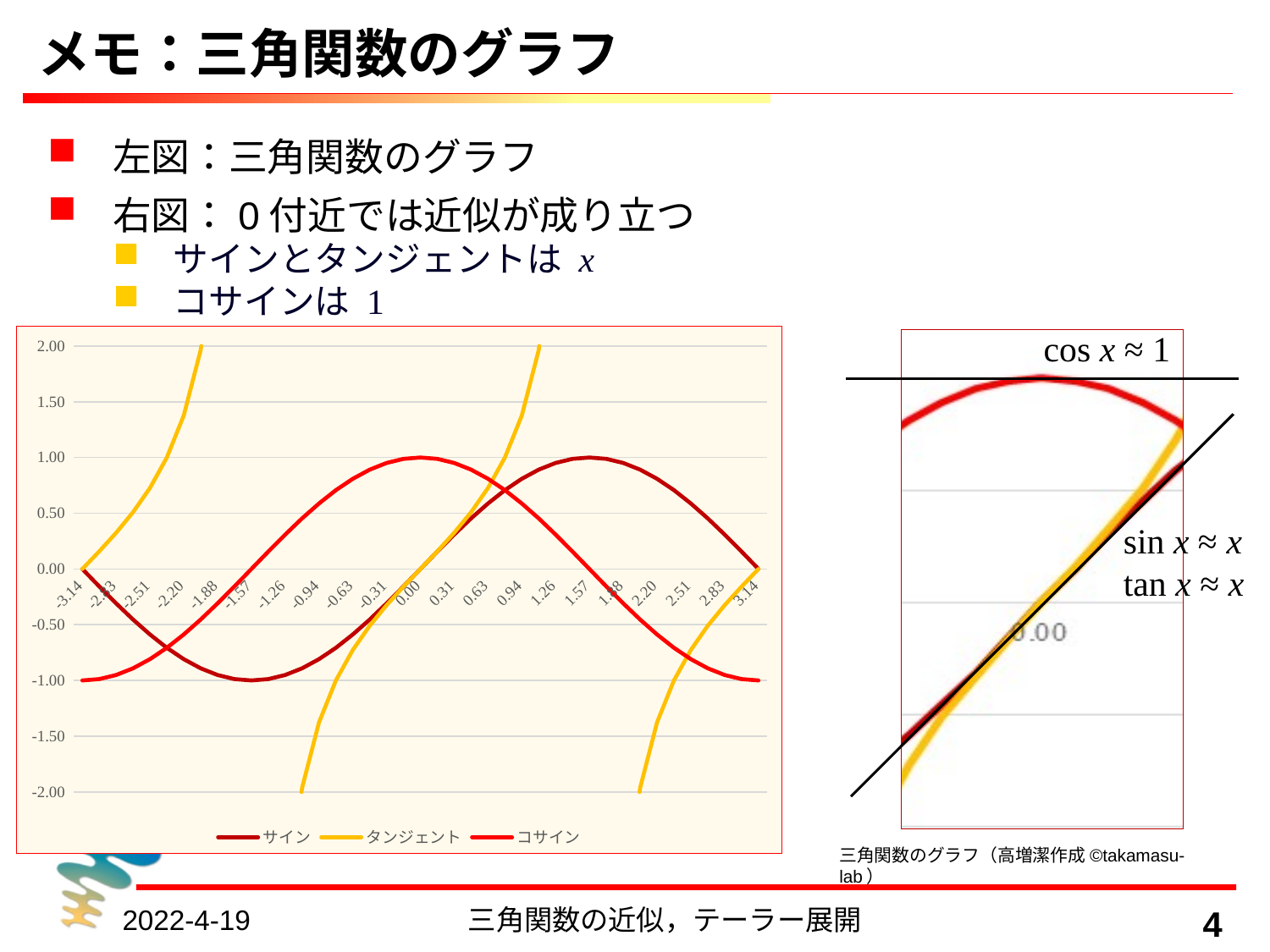
On the left chart, does the コサイン line rise or fall as x goes from 0.00 to 3.14? fall What kind of chart is shown on the left of the slide? line chart What is the highest value shown on the y axis of the left chart? 2.00 On the left chart, is the value of タンジェント at x = 0.94 greater or less than 1.00? greater How many series does the legend of the left chart list? 3 On the left chart, at x = 0.00, which is larger, サイン or コサイン? コサイン What are the three series named in the legend of the left chart? サイン, タンジェント, コサイン On the left chart, is the value of タンジェント at x = -0.94 greater or less than -1.00? less On the left chart, what is the value of サイン at x = 0.00? 0.00 On the left chart, what is the value of コサイン at x = 0.00? 1.00 On the left chart, what is the value of コサイン at x = 3.14? -1.00